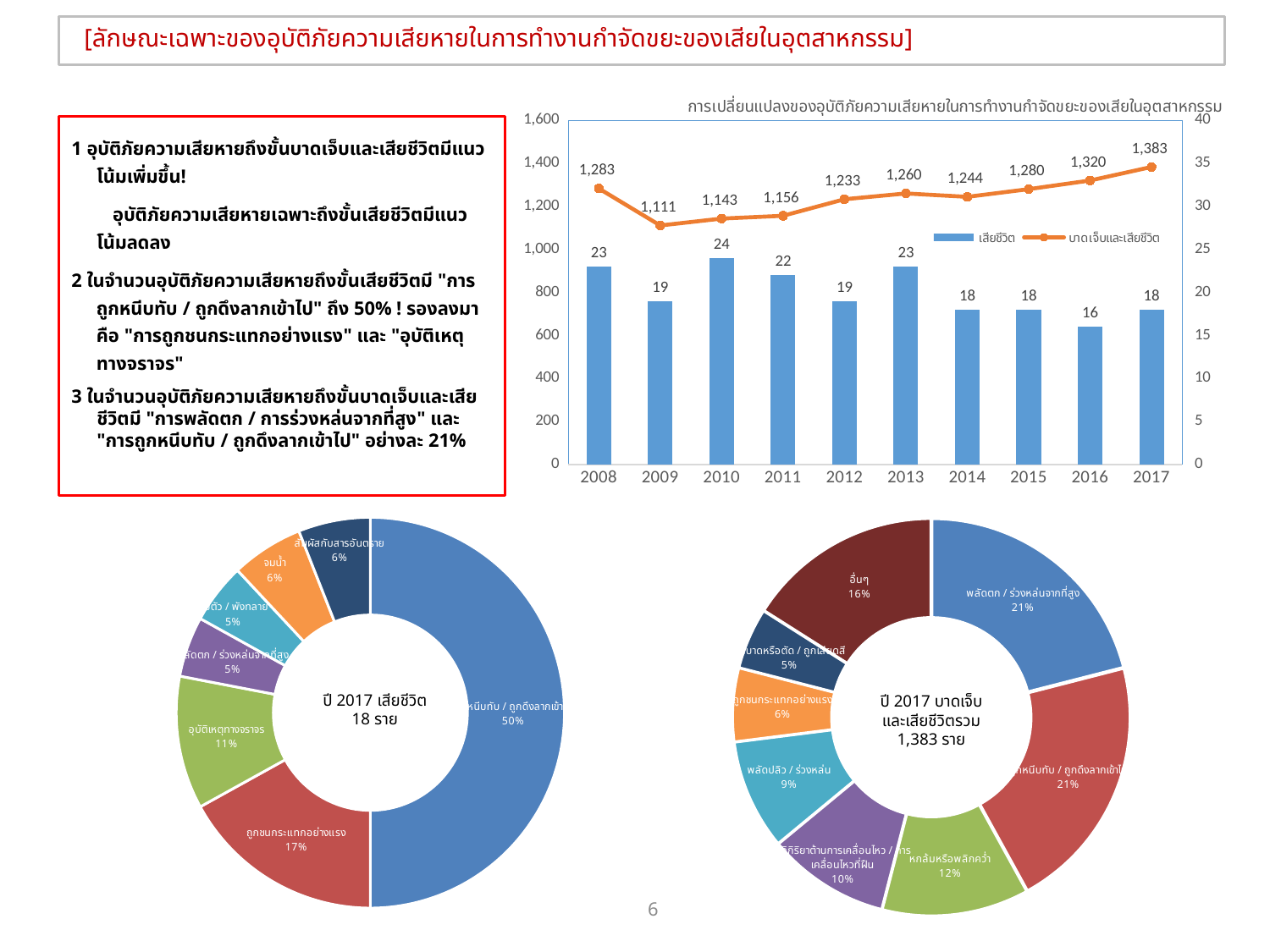
In the top-right line and bar chart, how many years are shown on the x axis? 10 In the top-right line and bar chart, what is the value of the บาดเจ็บและเสียชีวิต line for 2017? 1,383 In the bottom-right donut chart (ปี 2017 บาดเจ็บและเสียชีวิตรวม 1,383 ราย), what share does หกล้มหรือพลิกคว่ำ have? 12% In the top-right line and bar chart, what is the difference between the บาดเจ็บและเสียชีวิต values for 2017 and 2016? 63 In the top-right line and bar chart, how many series does the legend list? 2 In the bottom-left donut chart (ปี 2017 เสียชีวิต 18 ราย), what share does ถูกหนีบทับ / ถูกดึงลากเข้าไป have? 50% In the top-right line and bar chart, which year has the lowest เสียชีวิต bar? 2016 In the bottom-left donut chart (ปี 2017 เสียชีวิต 18 ราย), what share does อุบัติเหตุทางจราจร have? 11% In the top-right line and bar chart, what is the value of the เสียชีวิต bar for 2010? 24 In the top-right line and bar chart, does the บาดเจ็บและเสียชีวิต line rise or fall from 2013 to 2017? rise In the top-right line and bar chart, which year has the lowest value on the บาดเจ็บและเสียชีวิต line? 2009 In the top-right line and bar chart, is the เสียชีวิต bar higher in 2008 or in 2014? 2008